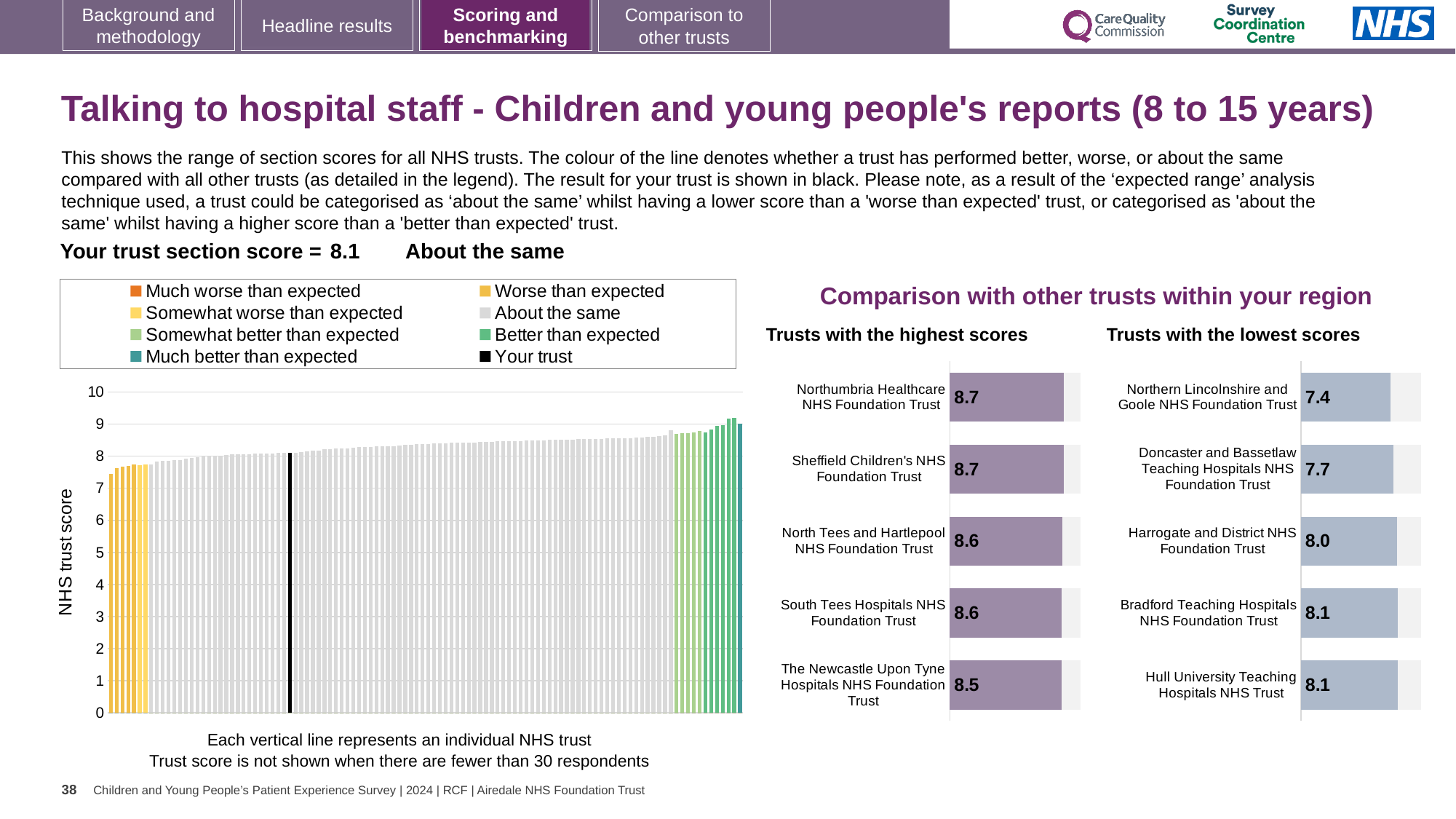
In the large chart on the left, what is the label on the vertical axis? NHS trust score In the 'Trusts with the highest scores' chart, what is the difference between Northumbria Healthcare NHS Foundation Trust and The Newcastle Upon Tyne Hospitals NHS Foundation Trust? 0.2 How many trusts are shown in the 'Trusts with the lowest scores' chart? 5 What kind of chart is the large chart on the left of the slide? bar chart In the 'Trusts with the lowest scores' chart, which is larger: Doncaster and Bassetlaw Teaching Hospitals NHS Foundation Trust or Harrogate and District NHS Foundation Trust? Harrogate and District NHS Foundation Trust In the 'Trusts with the lowest scores' chart, which trust has the lowest value? Northern Lincolnshire and Goole NHS Foundation Trust In the 'Trusts with the highest scores' chart, what is the value for North Tees and Hartlepool NHS Foundation Trust? 8.6 In the large chart on the left, is the value for the tallest bar greater or less than 9? greater In the 'Trusts with the highest scores' chart, which trust has the lowest value? The Newcastle Upon Tyne Hospitals NHS Foundation Trust In the 'Trusts with the lowest scores' chart, what is the value for Doncaster and Bassetlaw Teaching Hospitals NHS Foundation Trust? 7.7 How many entries does the legend above the large chart on the left list? 8 In the large chart on the left, is the value for the black 'Your trust' bar greater or less than 8? greater